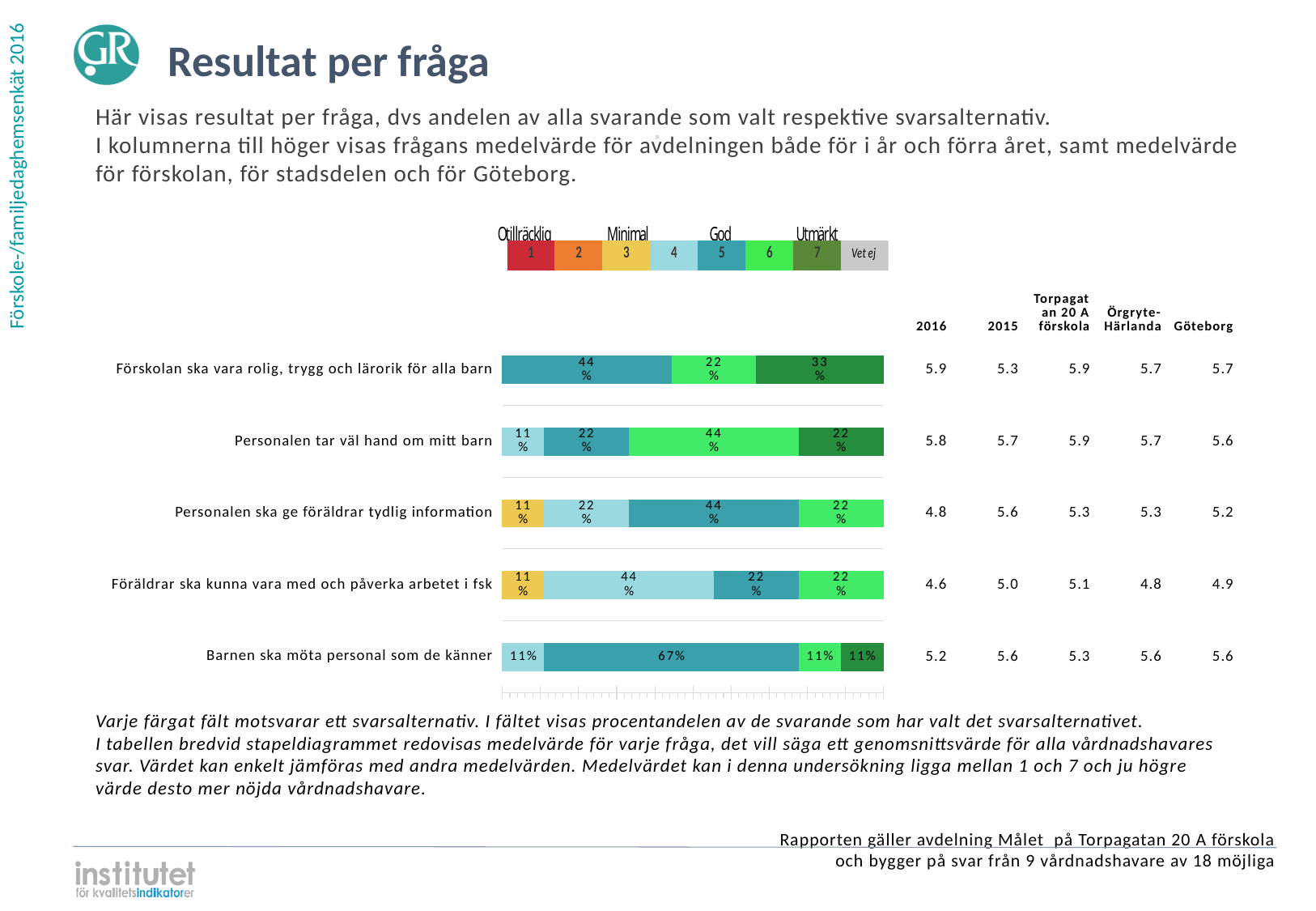
How many questions (categories) are shown in the bar chart? 5 What percentage of respondents chose alternative 6 (bright green) for 'Personalen tar väl hand om mitt barn'? 44% What is the 2016 mean value shown for 'Personalen ska ge föräldrar tydlig information'? 4.8 Which is larger for 'Personalen ska ge föräldrar tydlig information': the alternative 5 (teal) share or the alternative 4 (light blue) share? Alternative 5 (teal), 44% What is the largest single segment value shown in the bar for 'Barnen ska möta personal som de känner'? 67% How many response alternatives does the colour legend above the chart list? 8 What label does the legend give to the grey box at the right end of the response scale? Vet ej What percentage of respondents chose alternative 7 (dark green) for 'Förskolan ska vara rolig, trygg och lärorik för alla barn'? 33% What percentage of respondents chose alternative 4 (light blue) for 'Föräldrar ska kunna vara med och påverka arbetet i fsk'? 44% What kind of chart is used to show the response distribution per question? Stacked bar chart Which question has the lowest 2016 mean value in the table next to the chart? Föräldrar ska kunna vara med och påverka arbetet i fsk What is the difference between the alternative 5 (teal) share and the alternative 6 (bright green) share for 'Förskolan ska vara rolig, trygg och lärorik för alla barn'? 22 percentage points